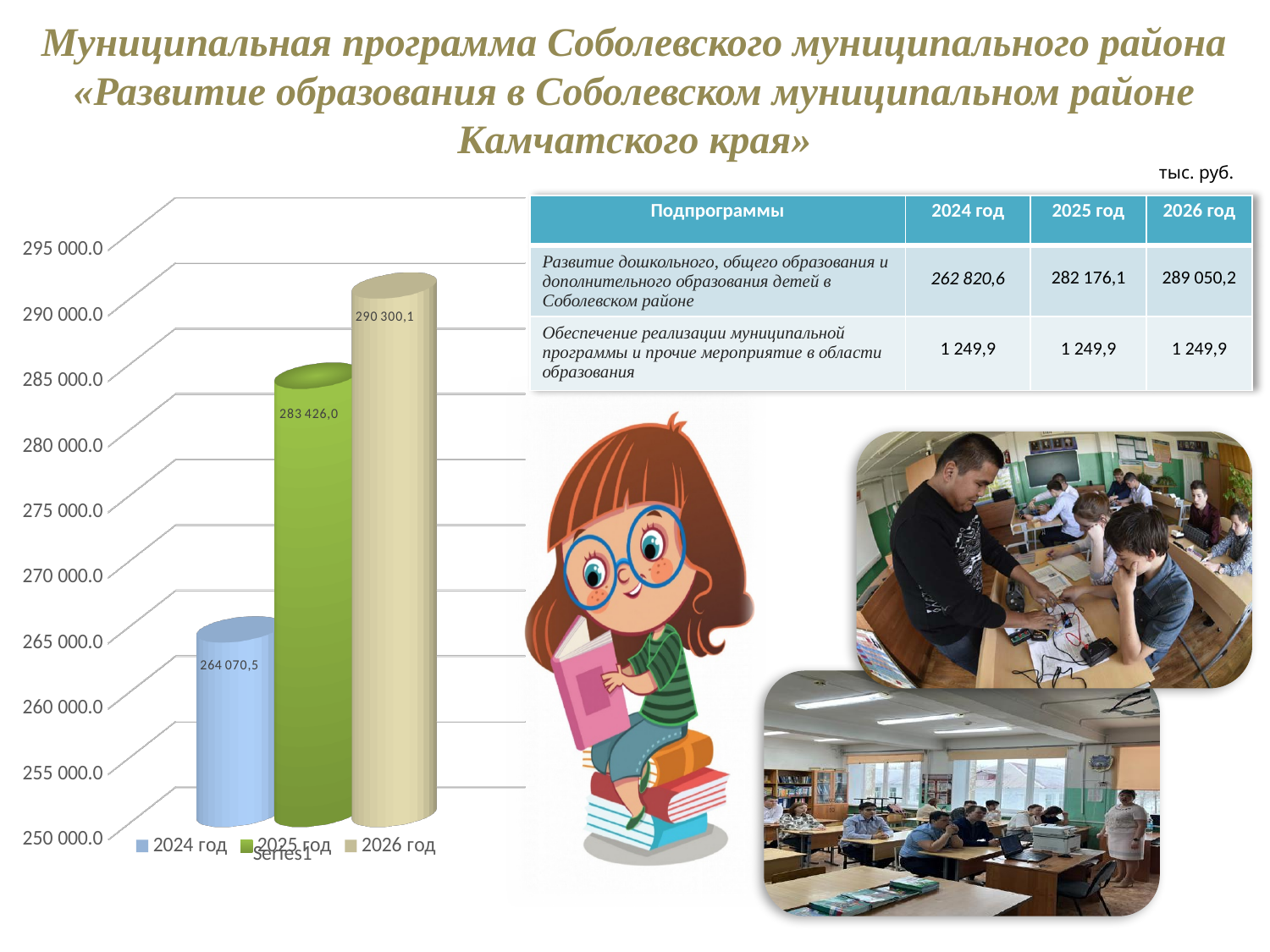
How many entries does the chart legend list? 3 Is the value for 2025 год greater or less than 280 000.0? greater What is the value shown for 2025 год on the chart? 283 426,0 What kind of chart is shown on the slide? bar chart What is the difference between the values for 2026 год and 2024 год on the chart? 26 229,6 What is the value shown for 2024 год on the chart? 264 070,5 How many bars are plotted on the chart? 3 Which year has the lowest value on the chart? 2024 год Which is larger on the chart, the value for 2025 год or the value for 2024 год? 2025 год What is the difference between the values for 2025 год and 2024 год on the chart? 19 355,5 What is the value shown for 2026 год on the chart? 290 300,1 Which year has the highest value on the chart? 2026 год